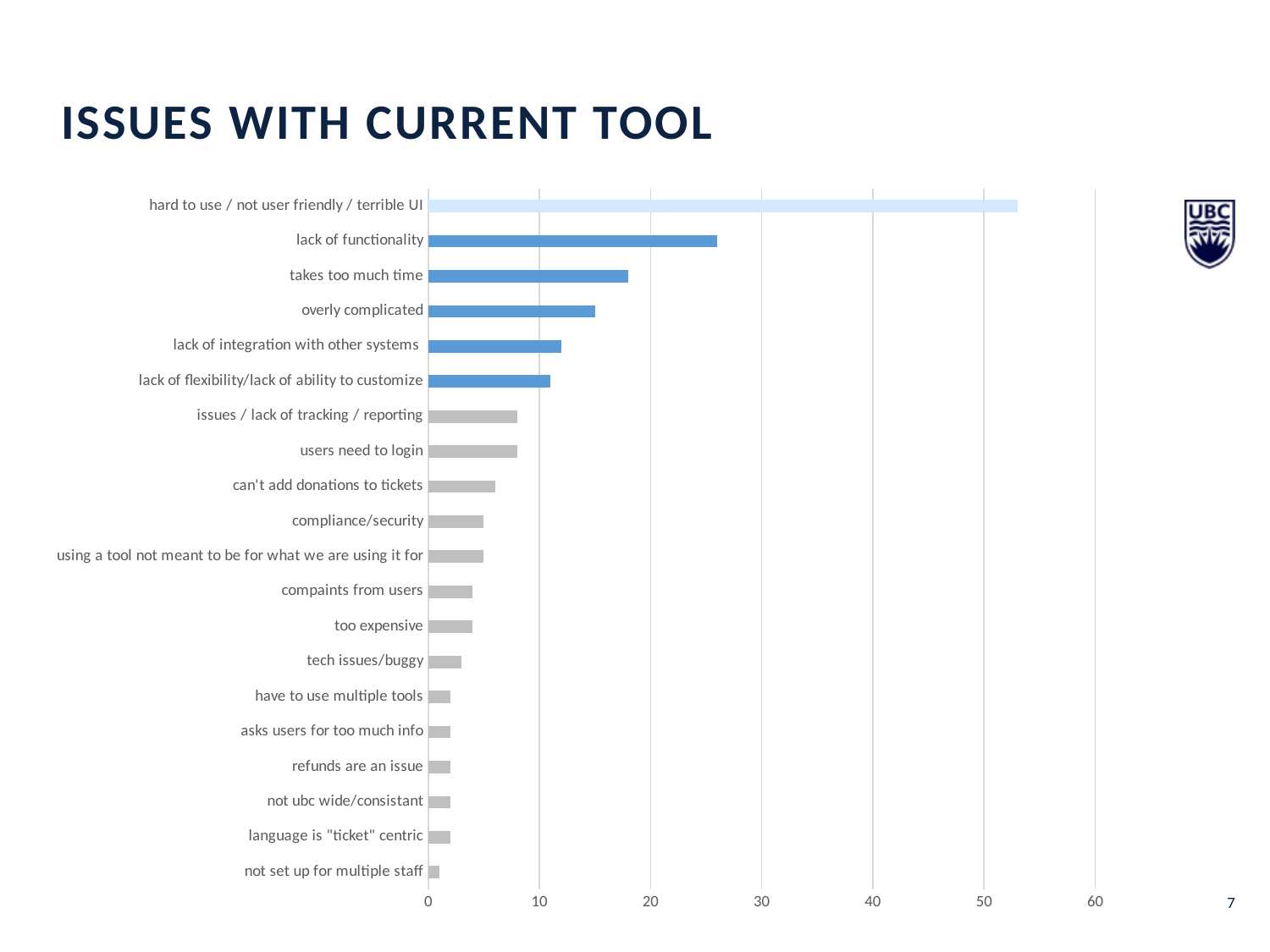
How many issue categories are plotted in the chart? 20 Which issue has the highest value in the chart? hard to use / not user friendly / terrible UI Which has a larger value, "lack of functionality" or "takes too much time"? lack of functionality Is the value for "issues / lack of tracking / reporting" greater or less than 10? less Which has a larger value, "overly complicated" or "lack of integration with other systems"? overly complicated Is the value for "overly complicated" greater or less than 10? greater What kind of chart is shown on the slide? bar chart What is the title of the slide containing the chart? ISSUES WITH CURRENT TOOL Is the value for "lack of functionality" greater or less than 20? greater Which issue has the lowest value in the chart? not set up for multiple staff